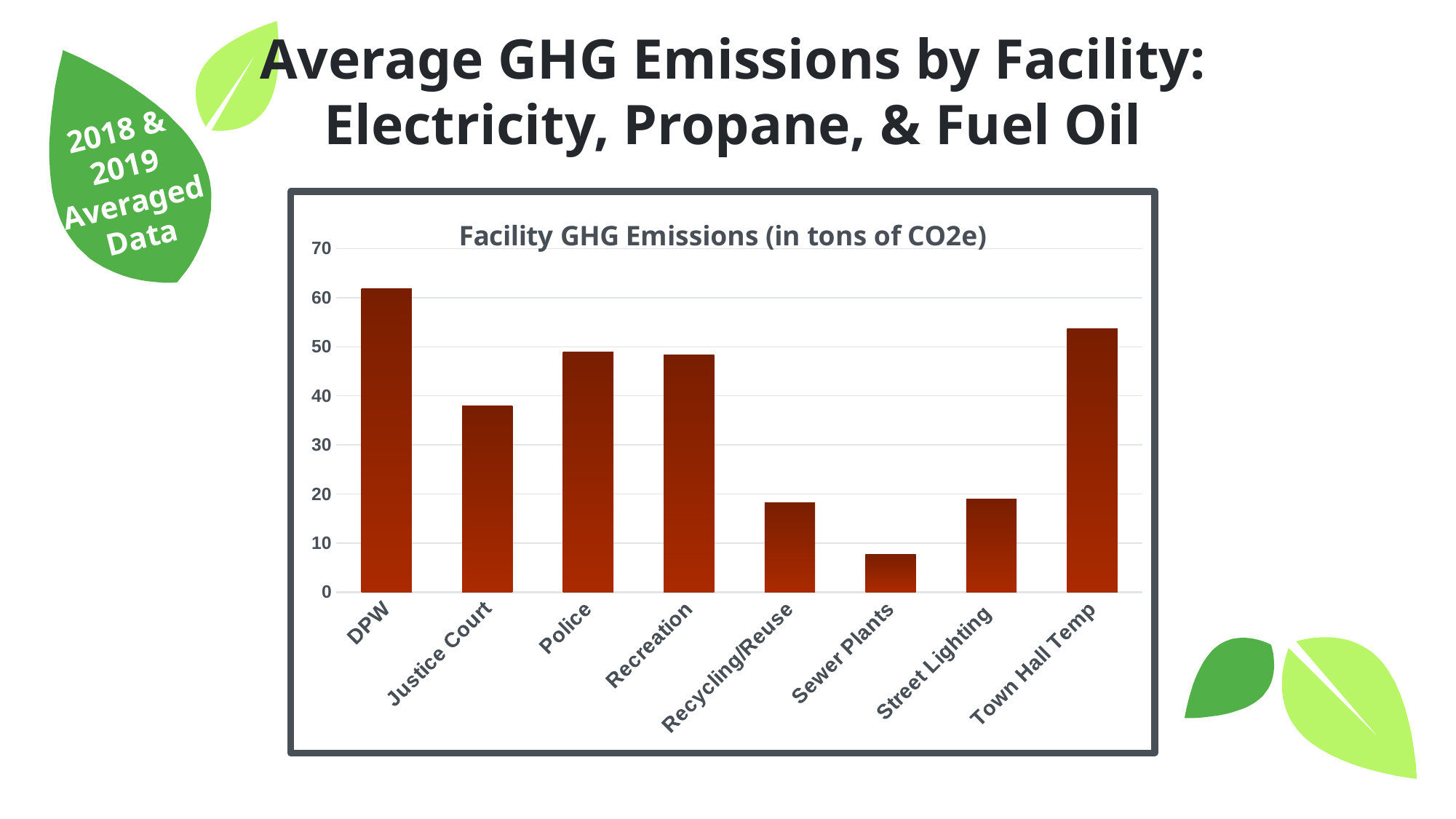
Which facility has the highest GHG emissions in the chart? DPW Is the value for Sewer Plants greater or less than 10? less Is the value for Street Lighting greater or less than 20? less Which has higher GHG emissions, Town Hall Temp or Recreation? Town Hall Temp What is the title of the chart inside the bordered box? Facility GHG Emissions (in tons of CO2e) Is the value for Justice Court greater or less than 40? less How many facilities are shown on the x axis of the chart? 8 Which has higher GHG emissions, Police or Justice Court? Police What type of chart is shown on the slide? bar chart Which facility has the lowest GHG emissions in the chart? Sewer Plants